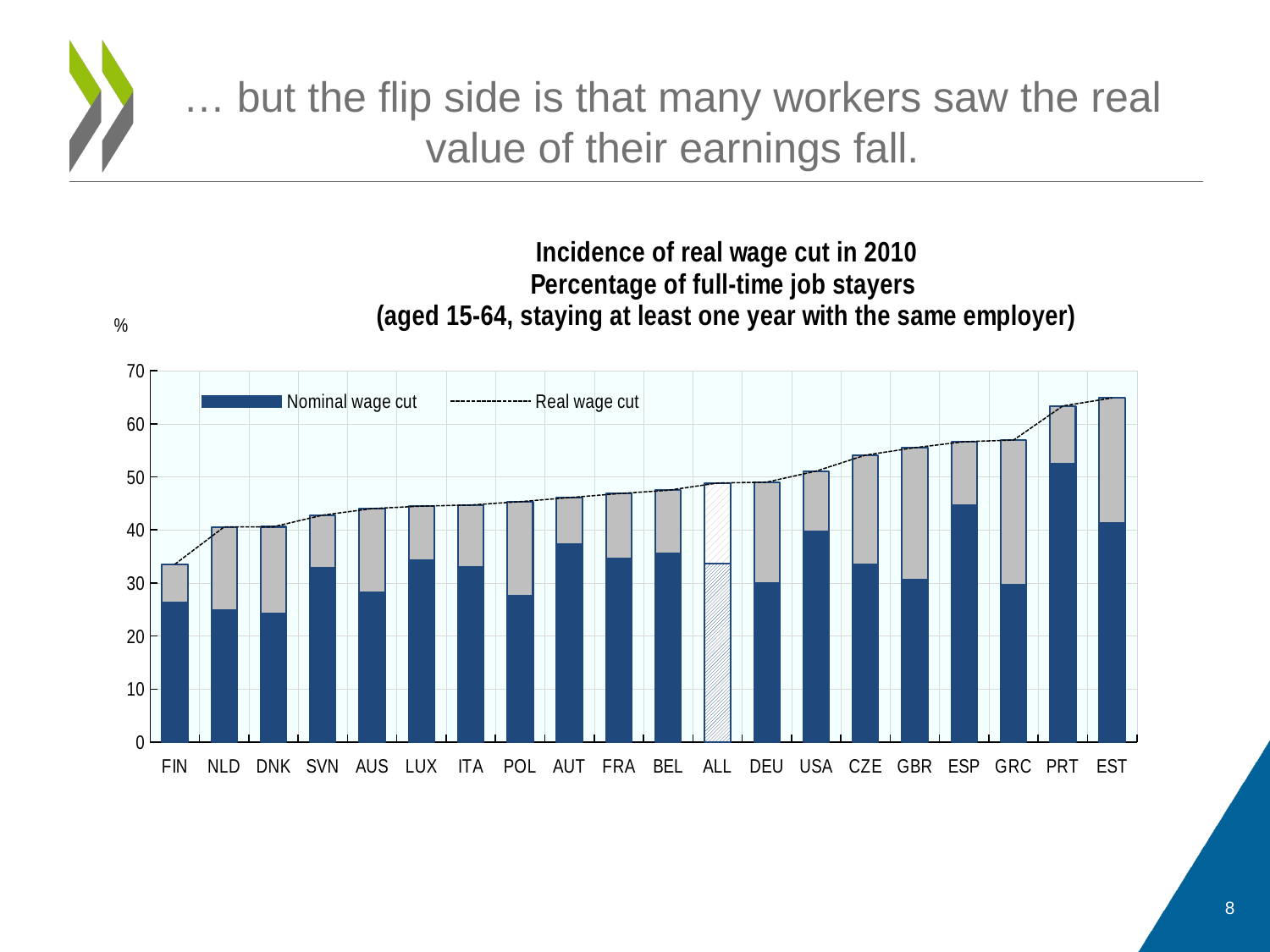
Which has the larger nominal wage cut, PRT or ESP? PRT How many countries/categories are shown along the x axis? 20 How many series does the legend list? 2 What kind of chart is shown on the slide? bar and line chart Is the real wage cut for EST greater or less than 60? greater Is the nominal wage cut for DNK greater or less than 30? less Do the real wage cut values rise or fall moving from left to right along the x axis? rise Which category has the highest real wage cut? EST Which category has the highest nominal wage cut? PRT Is the nominal wage cut for PRT greater or less than 50? greater What are the two entries listed in the chart legend? Nominal wage cut and Real wage cut Which category has the lowest real wage cut? FIN